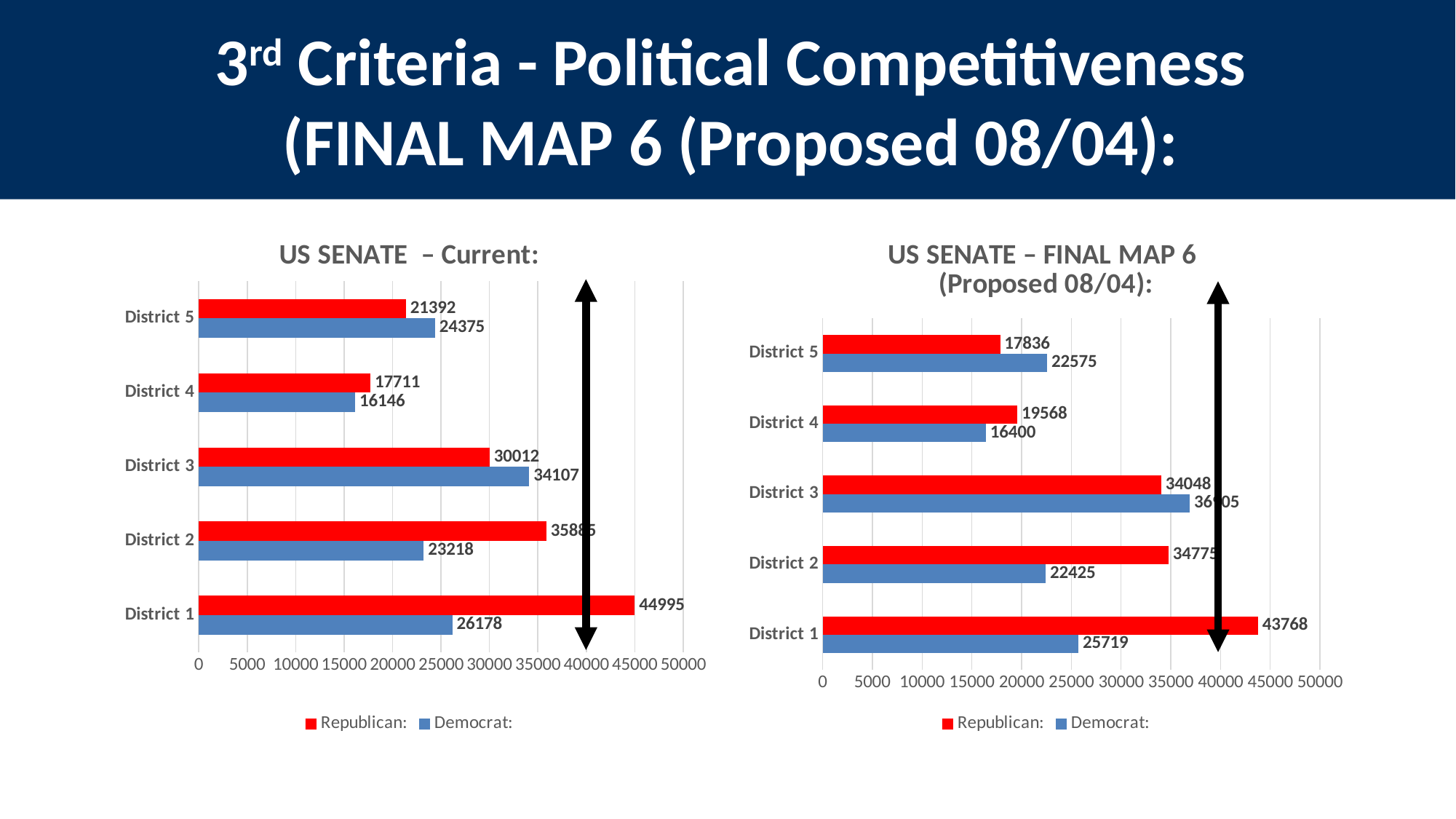
In the US SENATE – Current chart, what is the difference between the Republican and Democrat values for District 1? 18817 In the US SENATE – FINAL MAP 6 chart, what is the Republican value for District 2? 34775 In the US SENATE – Current chart, what is the Democrat value for District 3? 34107 In the US SENATE – Current chart, which district has the highest Republican value? District 1 In the US SENATE – FINAL MAP 6 chart, is the Republican value for District 1 greater or less than 40000? greater In the US SENATE – FINAL MAP 6 chart, which district has the lowest Democrat value? District 4 In the US SENATE – FINAL MAP 6 chart, what is the Democrat value for District 5? 22575 In the US SENATE – FINAL MAP 6 chart, which is larger for District 4, the Republican value or the Democrat value? Republican How many series does the legend of the US SENATE – FINAL MAP 6 chart list? 2 What type of chart is the US SENATE – Current chart? Bar chart In the US SENATE – Current chart, what is the Republican value for District 1? 44995 How many districts are shown in the US SENATE – Current chart? 5